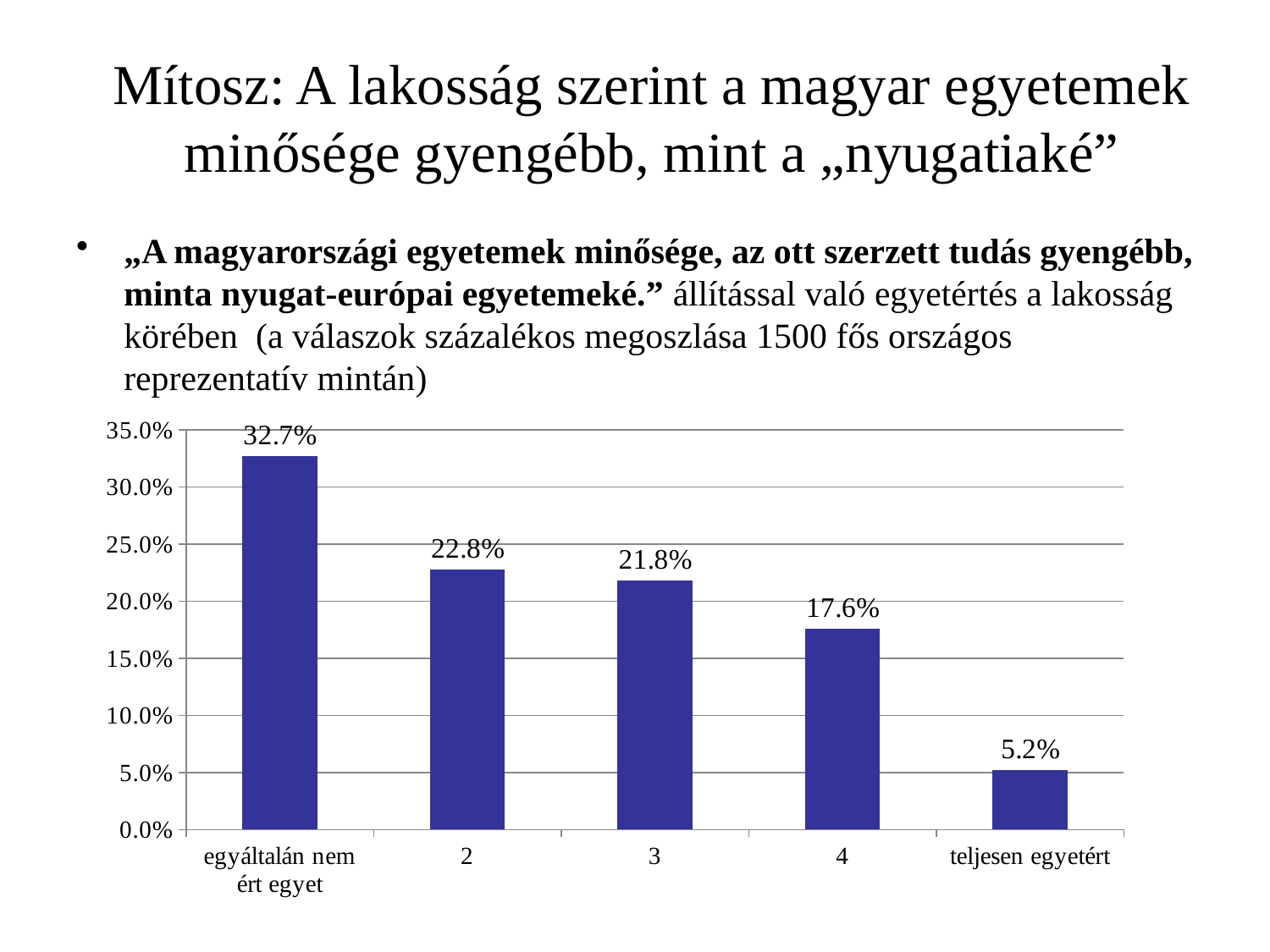
Which category has the highest value? egyáltalán nem ért egyet What is the value for "egyáltalán nem ért egyet"? 32.7% Which category has the lowest value? teljesen egyetért How many categories are shown on the x axis? 5 Do the values rise or fall from left to right along the x axis? fall What is the value for "teljesen egyetért"? 5.2% What is the difference between the values for category 2 and category 4? 5.2% What is the difference between the values for "egyáltalán nem ért egyet" and "teljesen egyetért"? 27.5% What kind of chart is shown on the slide? bar chart Is the value for category 4 greater or less than 20.0%? less What is the value for category 3? 21.8% Which is larger, the value for category 2 or category 4? 2